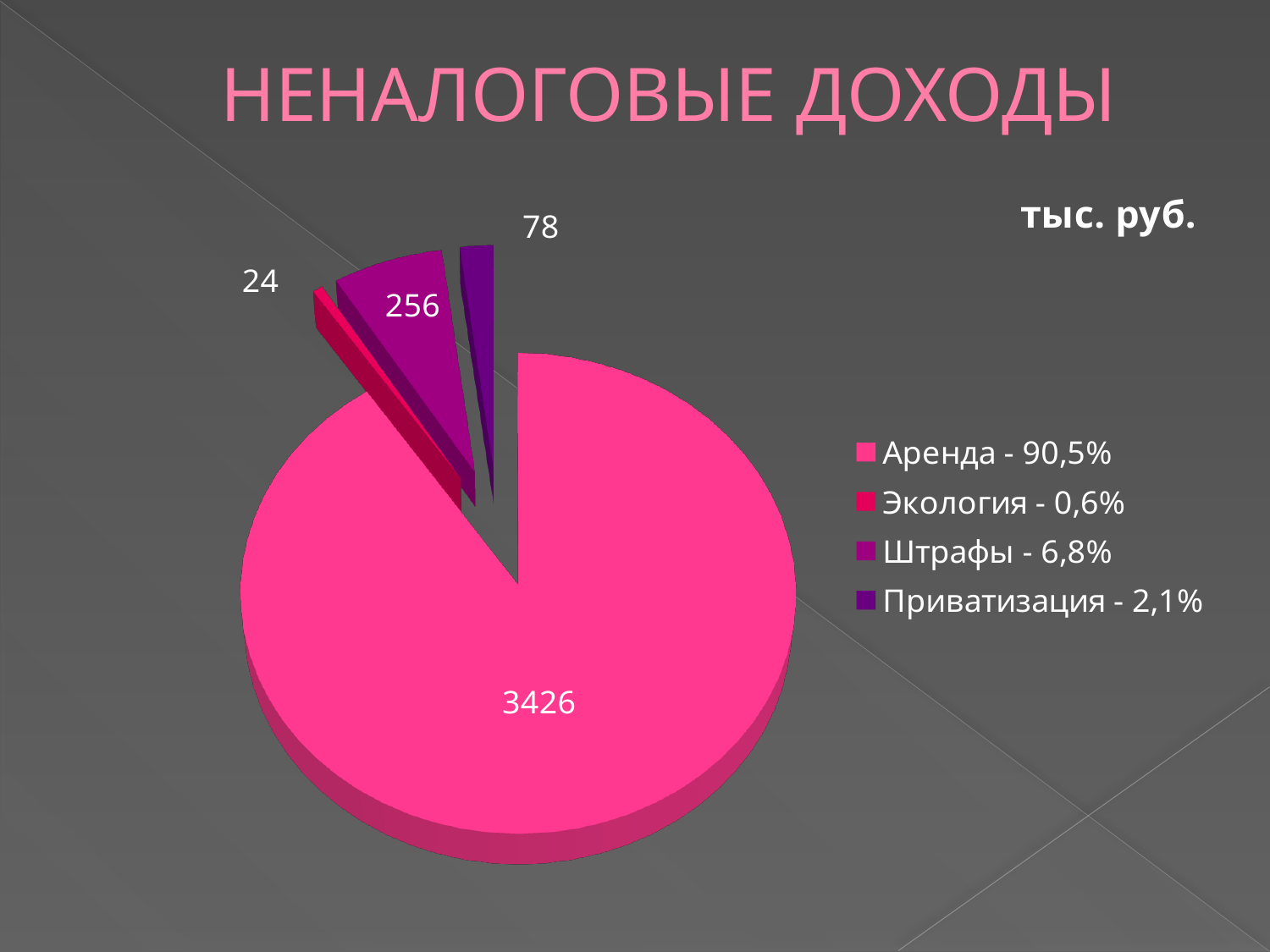
Which category has the smallest slice of the pie? Экология What is the value for Приватизация? 78 What is the value for Аренда? 3426 What is the difference between the values for Штрафы and Приватизация? 178 Which is larger, the value for Приватизация or the value for Экология? Приватизация What kind of chart is shown on the slide? pie chart How many categories does the pie chart have? 4 What unit is stated for the values on the chart? тыс. руб. Which category has the largest slice of the pie? Аренда What is the value for Штрафы? 256 What is the value for Экология? 24 What share of the pie does Штрафы represent, according to the legend? 6,8%